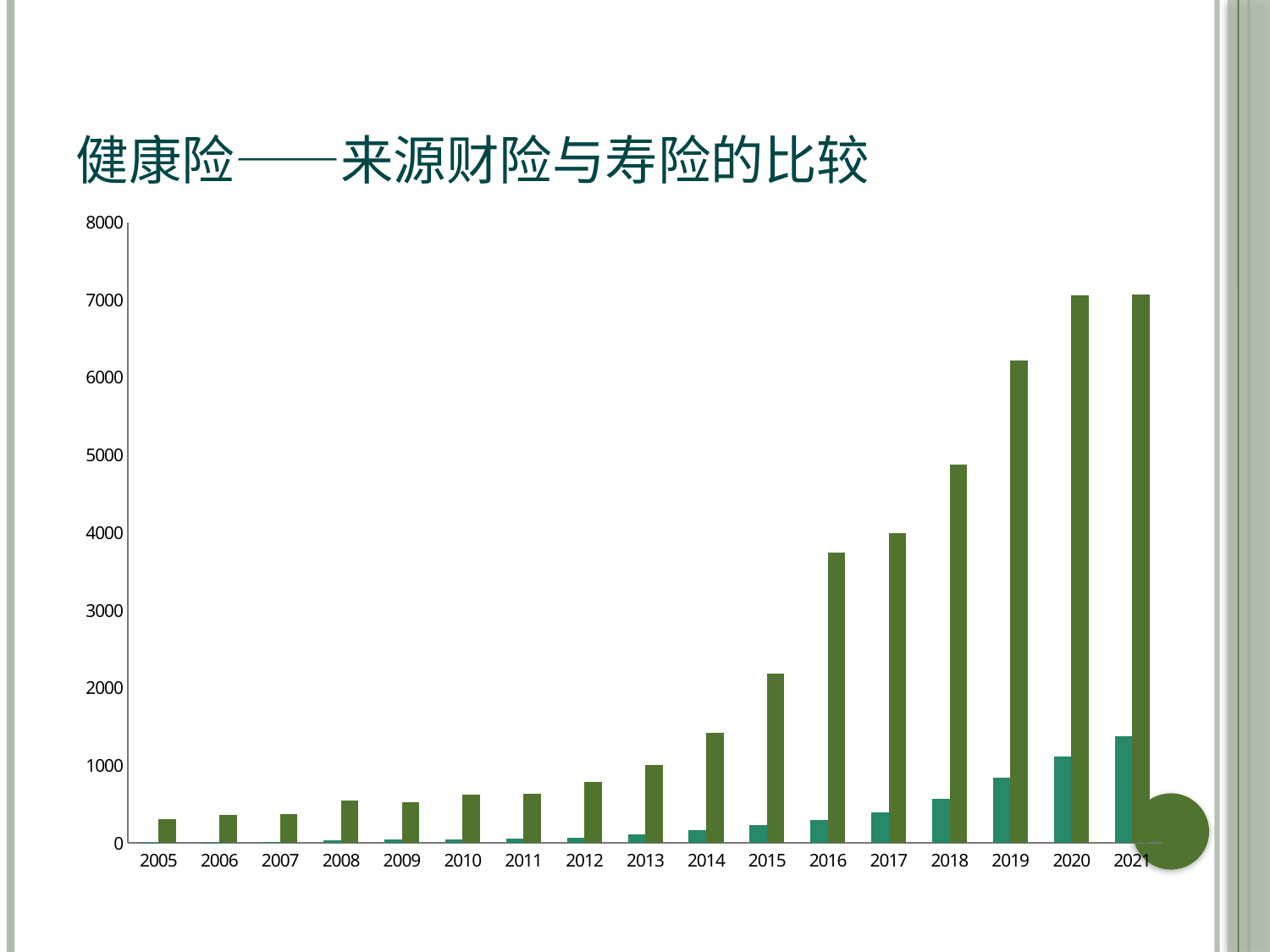
Is the dark green bar for 2019 greater or less than 6000? greater Do the dark green bars generally rise or fall from 2005 to 2021? rise Is the dark green bar for 2016 greater or less than 3000? greater What is the highest value shown on the y axis of the chart? 8000 What kind of chart is shown on the slide? bar chart In 2021, which bar is larger, the teal bar or the dark green bar? the dark green bar How many years are shown along the x axis of the chart? 17 What is the title of the chart on the slide? 健康险——来源财险与寿险的比较 What is the last year shown on the x axis of the chart? 2021 Is the dark green bar for 2018 greater or less than 5000? less What is the first year shown on the x axis of the chart? 2005